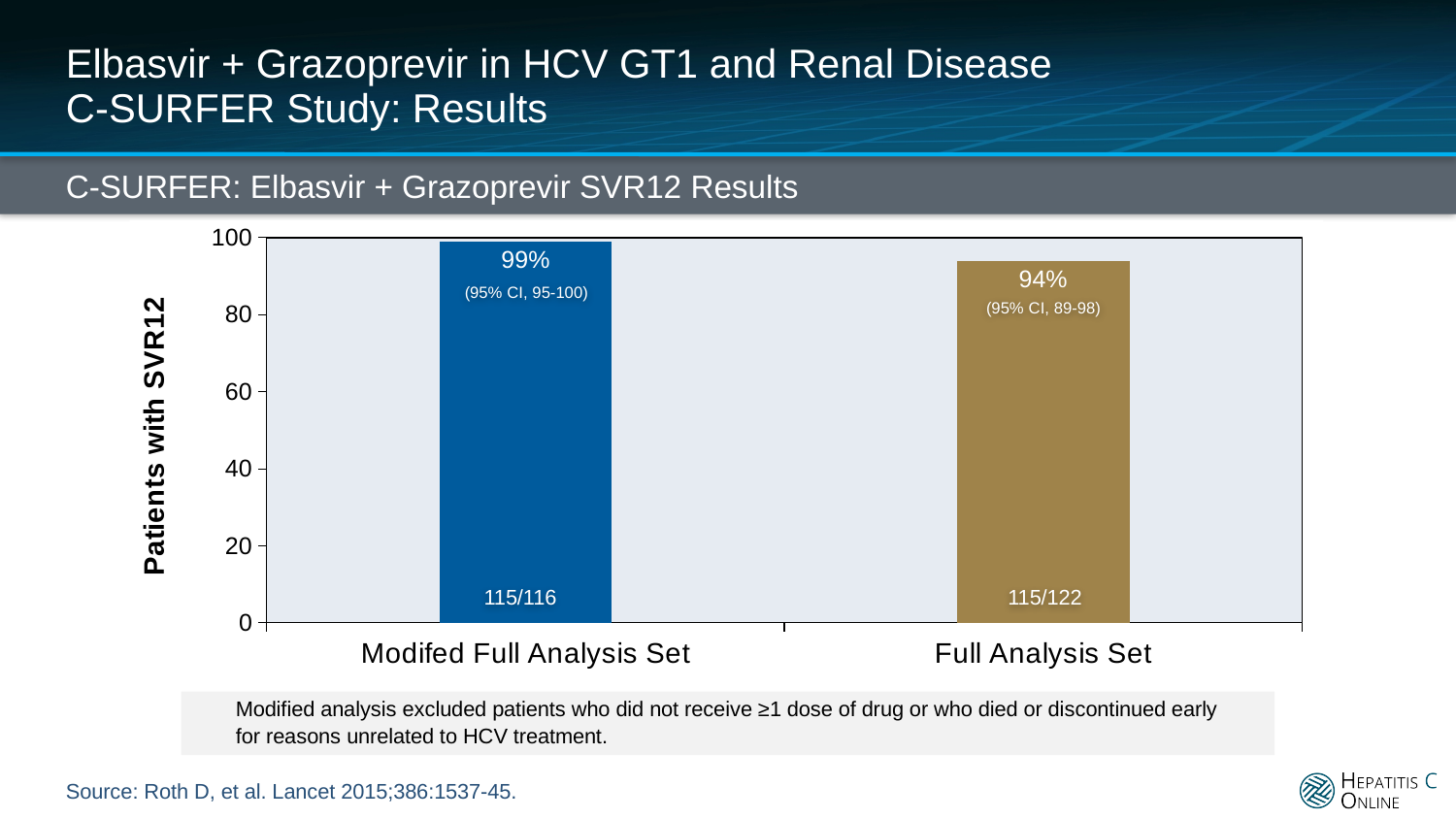
What type of chart is shown on the slide? Bar chart How many categories are shown on the x axis of the chart? 2 Which analysis set has the higher SVR12 rate? Modified Full Analysis Set What is the SVR12 rate for the Full Analysis Set? 94% How many patients achieved SVR12 out of the total in the Modified Full Analysis Set? 115/116 What is the 95% confidence interval for the SVR12 rate in the Modified Full Analysis Set? 95-100 What is the 95% confidence interval for the SVR12 rate in the Full Analysis Set? 89-98 Is the SVR12 rate for the Full Analysis Set greater or less than 80? greater Which analysis set has the lower SVR12 rate? Full Analysis Set How many patients achieved SVR12 out of the total in the Full Analysis Set? 115/122 What is the SVR12 rate for the Modified Full Analysis Set? 99% What is the difference in SVR12 rate between the Modified Full Analysis Set and the Full Analysis Set? 5%